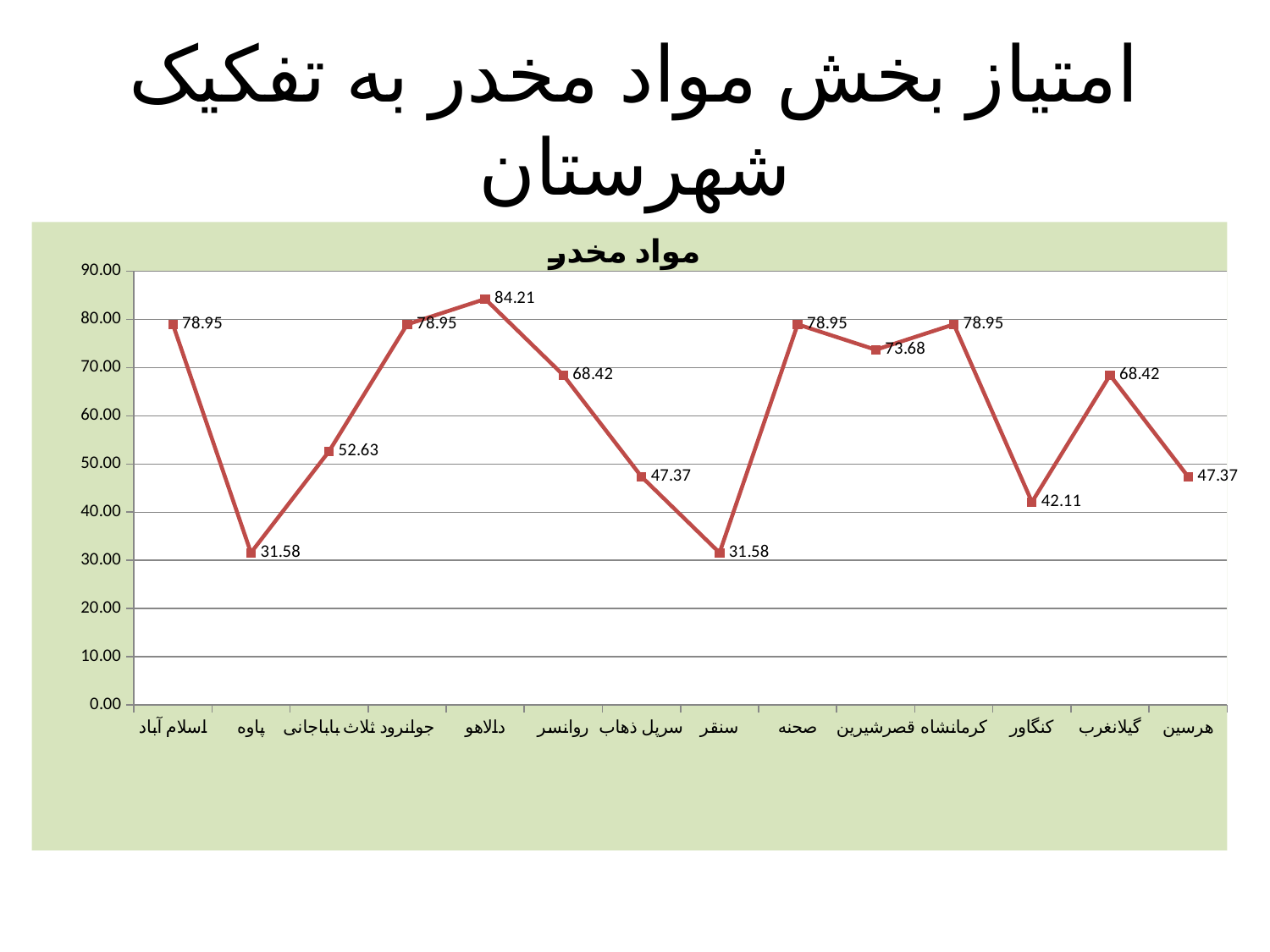
Which has a larger value, روانسر or سرپل ذهاب? روانسر What is the title of the chart? مواد مخدر How many categories are plotted on the x axis? 14 What is the value for قصرشیرین? 73.68 What type of chart is shown on the slide? line chart What is the lowest value plotted on the chart? 31.58 What is the value for دالاهو? 84.21 Is the value for هرسین greater or less than 50.00? less What is the value for کنگاور? 42.11 What is the value for ثلاث باباجانی? 52.63 Which category has the highest value? دالاهو What is the difference between the values for دالاهو and پاوه? 52.63